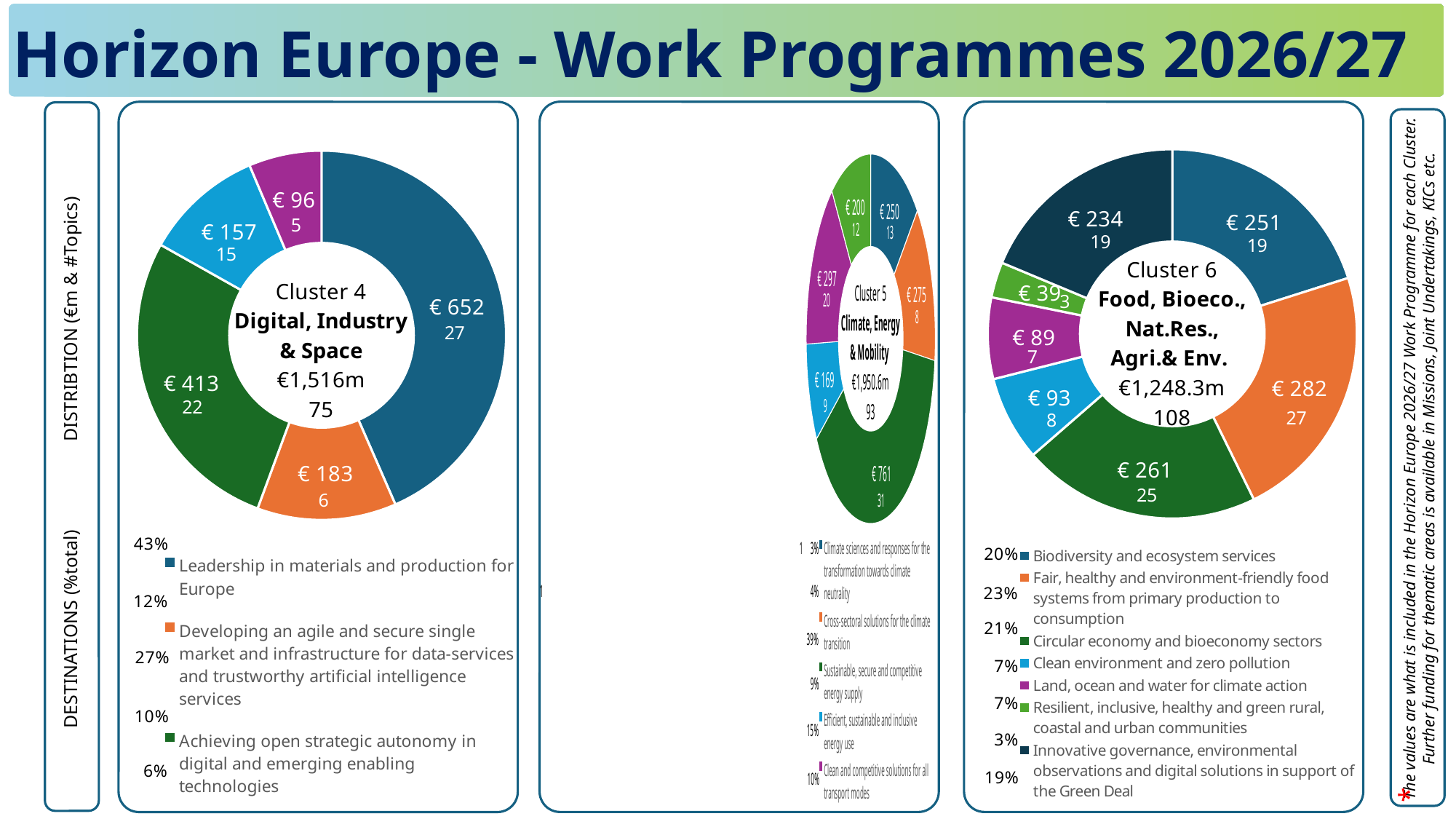
In the Cluster 6 chart, what is the value for 'Fair, healthy and environment-friendly food systems from primary production to consumption'? € 282 How many segments does the Cluster 6 donut chart have? 7 In the Cluster 4 chart, what is the difference between the € 652 segment and the € 413 segment? € 239 How many segments does the Cluster 4 donut chart have? 5 What kind of chart is used for each cluster on this slide? Donut (pie) chart In the Cluster 4 chart, which segment has the largest value? Leadership in materials and production for Europe (€ 652) What total amount is shown in the centre of the Cluster 5 chart? €1,950.6m What total amount is shown in the centre of the Cluster 4 chart? €1,516m In the Cluster 6 chart, what share of the total is 'Biodiversity and ecosystem services'? 20% In the Cluster 5 chart, which segment has the largest value? € 761 (Sustainable, secure and competitive energy supply) In the Cluster 6 chart, which segment has the smallest value? € 39 (Resilient, inclusive, healthy and green rural, coastal and urban communities) In the Cluster 4 chart, what is the value (€m) for the segment 'Leadership in materials and production for Europe'? € 652